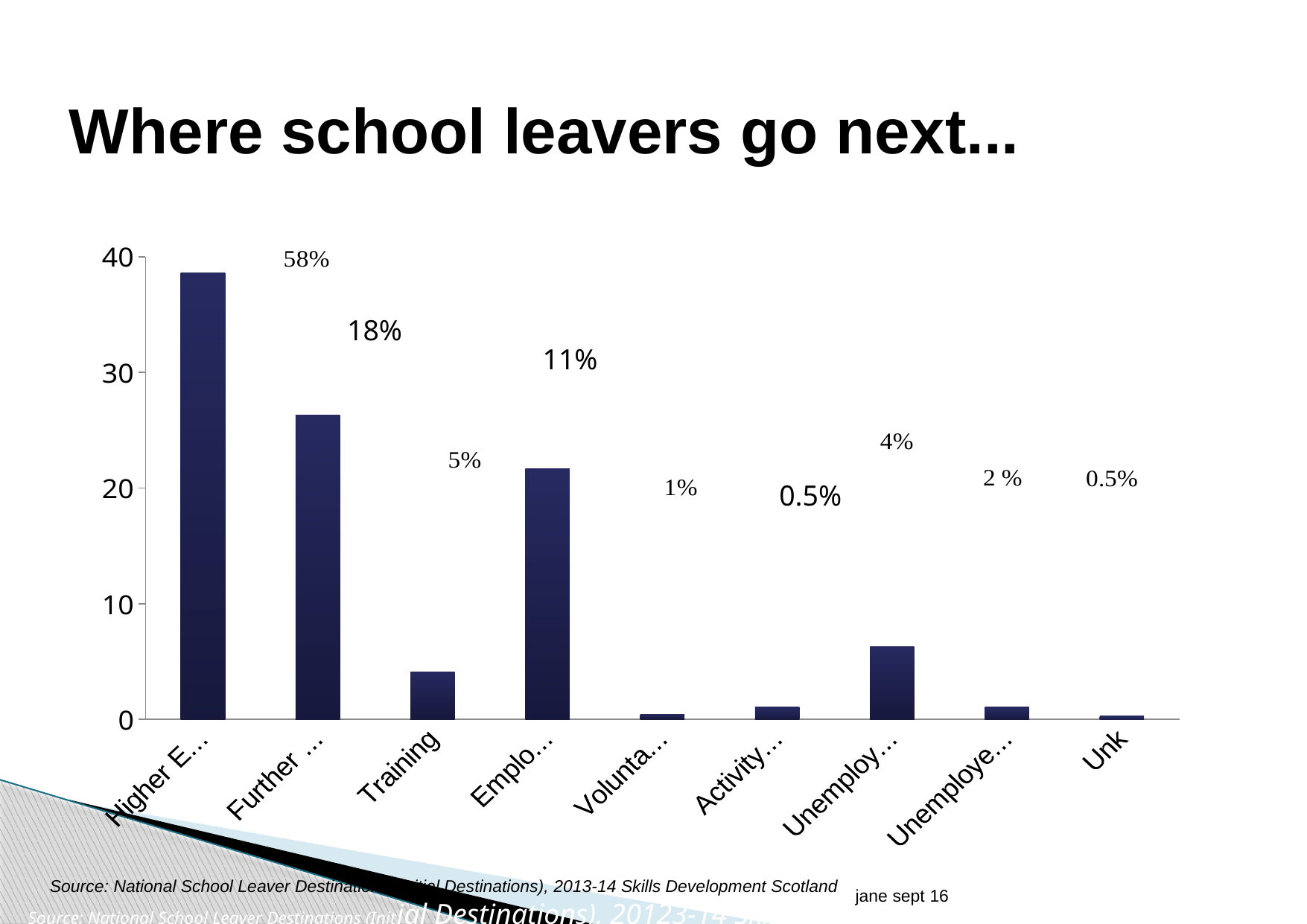
Which bar is taller, Higher E… or Further …? Higher E… Which category has the tallest bar in the chart? Higher E… What percentage label is printed above the Unk bar? 0.5% Is the value for Training greater or less than 10? less How many categories (bars) are plotted in the chart? 9 Is the value for Unemploy… greater or less than 10? less Which bar is taller, Training or Emplo…? Emplo… What kind of chart is shown on the slide? bar chart What is the title of the slide containing the chart? Where school leavers go next... What percentage label is printed above the Training bar? 5% Is the value for Further … greater or less than 20? greater